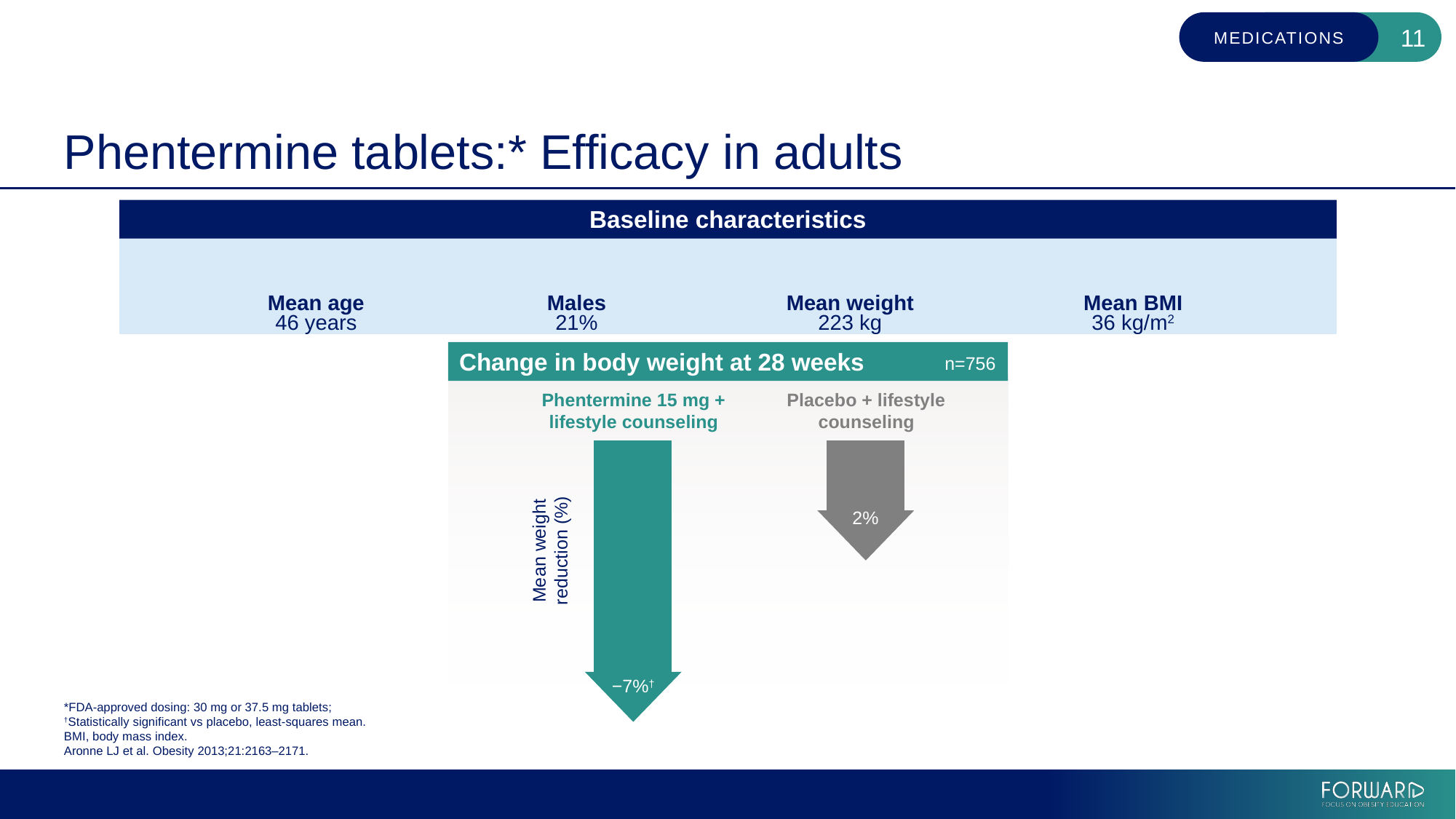
What is the sample size (n) shown for the change in body weight graphic? n=756 What is the title of the graphic showing the weight change? Change in body weight at 28 weeks What is the mean weight reduction shown for Placebo + lifestyle counseling? 2% How many treatment groups are shown in the change in body weight graphic? 2 What is the mean weight reduction shown for Phentermine 15 mg + lifestyle counseling? −7% Which treatment group shows the smaller mean weight reduction? Placebo + lifestyle counseling What is the label on the vertical axis of the weight change graphic? Mean weight reduction (%) Which treatment group shows the larger mean weight reduction? Phentermine 15 mg + lifestyle counseling At how many weeks is the change in body weight measured? 28 weeks Is the mean weight reduction larger for Phentermine 15 mg + lifestyle counseling or for Placebo + lifestyle counseling? Phentermine 15 mg + lifestyle counseling